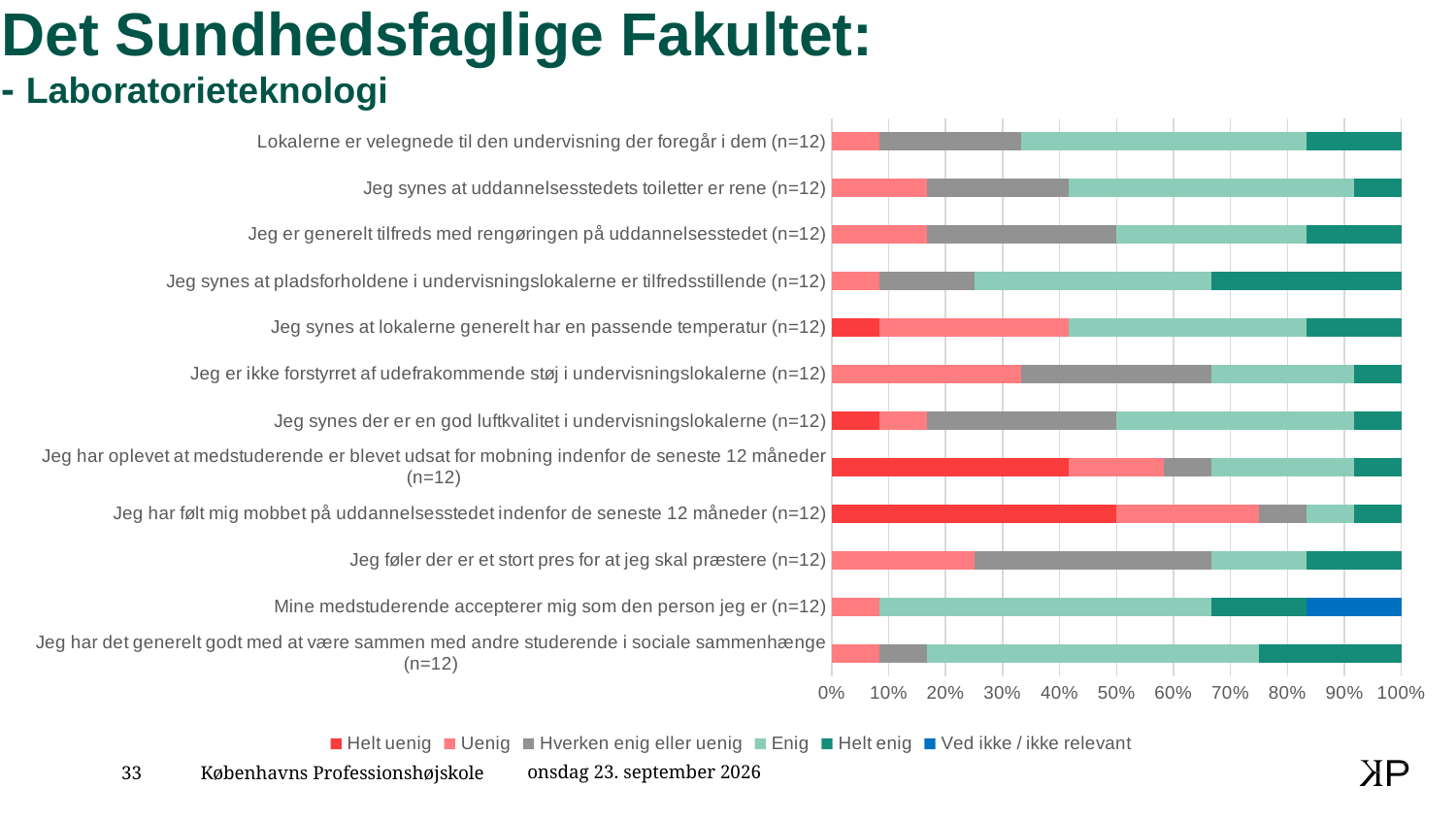
How many series does the legend list? 6 How many statements (categories) are plotted in the chart? 12 What is the last entry in the chart legend? Ved ikke / ikke relevant Which statement has the largest 'Helt enig' share? Jeg synes at pladsforholdene i undervisningslokalerne er tilfredsstillende (n=12) Is the 'Helt enig' share for 'Jeg synes at uddannelsesstedets toiletter er rene' greater or less than 20%? less Which has the larger 'Helt uenig' share: 'Jeg har følt mig mobbet på uddannelsesstedet indenfor de seneste 12 måneder' or 'Jeg har oplevet at medstuderende er blevet udsat for mobning indenfor de seneste 12 måneder'? Jeg har følt mig mobbet på uddannelsesstedet indenfor de seneste 12 måneder What type of chart is shown on the slide? Stacked bar chart What does each stacked bar in the chart total? 100% Which statement has the largest 'Helt uenig' share? Jeg har følt mig mobbet på uddannelsesstedet indenfor de seneste 12 måneder (n=12) Is the 'Helt uenig' share for 'Jeg har følt mig mobbet på uddannelsesstedet indenfor de seneste 12 måneder' greater or less than 40%? greater Which statement is the only one with a 'Ved ikke / ikke relevant' segment? Mine medstuderende accepterer mig som den person jeg er (n=12) Is the 'Enig' share for 'Mine medstuderende accepterer mig som den person jeg er' greater or less than 50%? greater